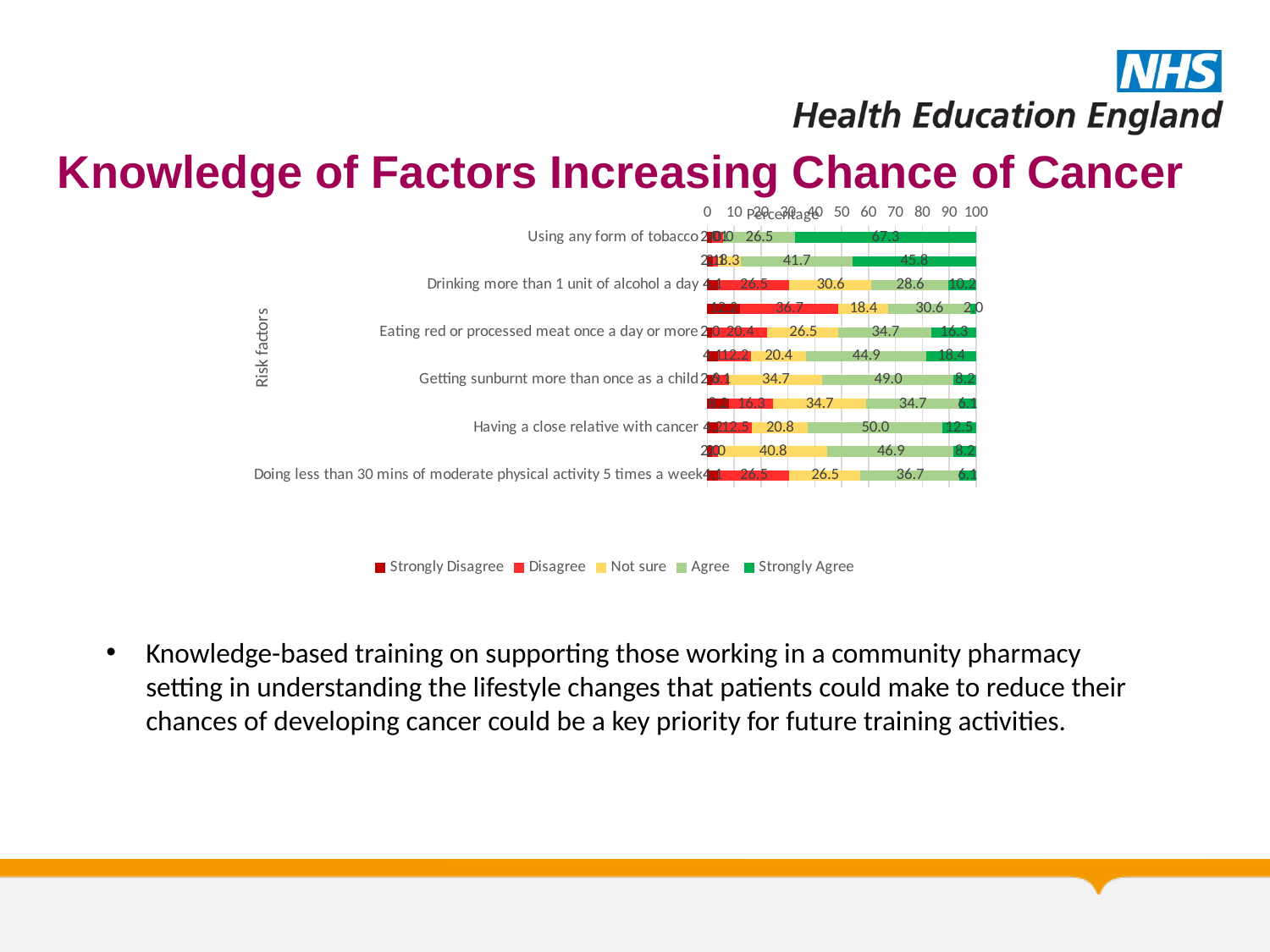
How many series does the legend list? 5 What is the Strongly Agree value for 'Using any form of tobacco'? 67.3 What is the title of the horizontal axis? Percentage Which is larger: the Agree value for 'Eating red or processed meat once a day or more' or the Agree value for 'Getting sunburnt more than once as a child'? Getting sunburnt more than once as a child What is the difference between the Strongly Agree value for 'Using any form of tobacco' and the Strongly Agree value for 'Drinking more than 1 unit of alcohol a day'? 57.1 What is the Agree value for 'Getting sunburnt more than once as a child'? 49.0 What is the title of the vertical axis? Risk factors What is the Not sure value for 'Drinking more than 1 unit of alcohol a day'? 30.6 What is the Agree value for 'Having a close relative with cancer'? 50.0 What is the Strongly Agree value for 'Doing less than 30 mins of moderate physical activity 5 times a week'? 6.1 What kind of chart is shown on the slide? Stacked bar chart Which risk factor has the highest Strongly Agree value? Using any form of tobacco